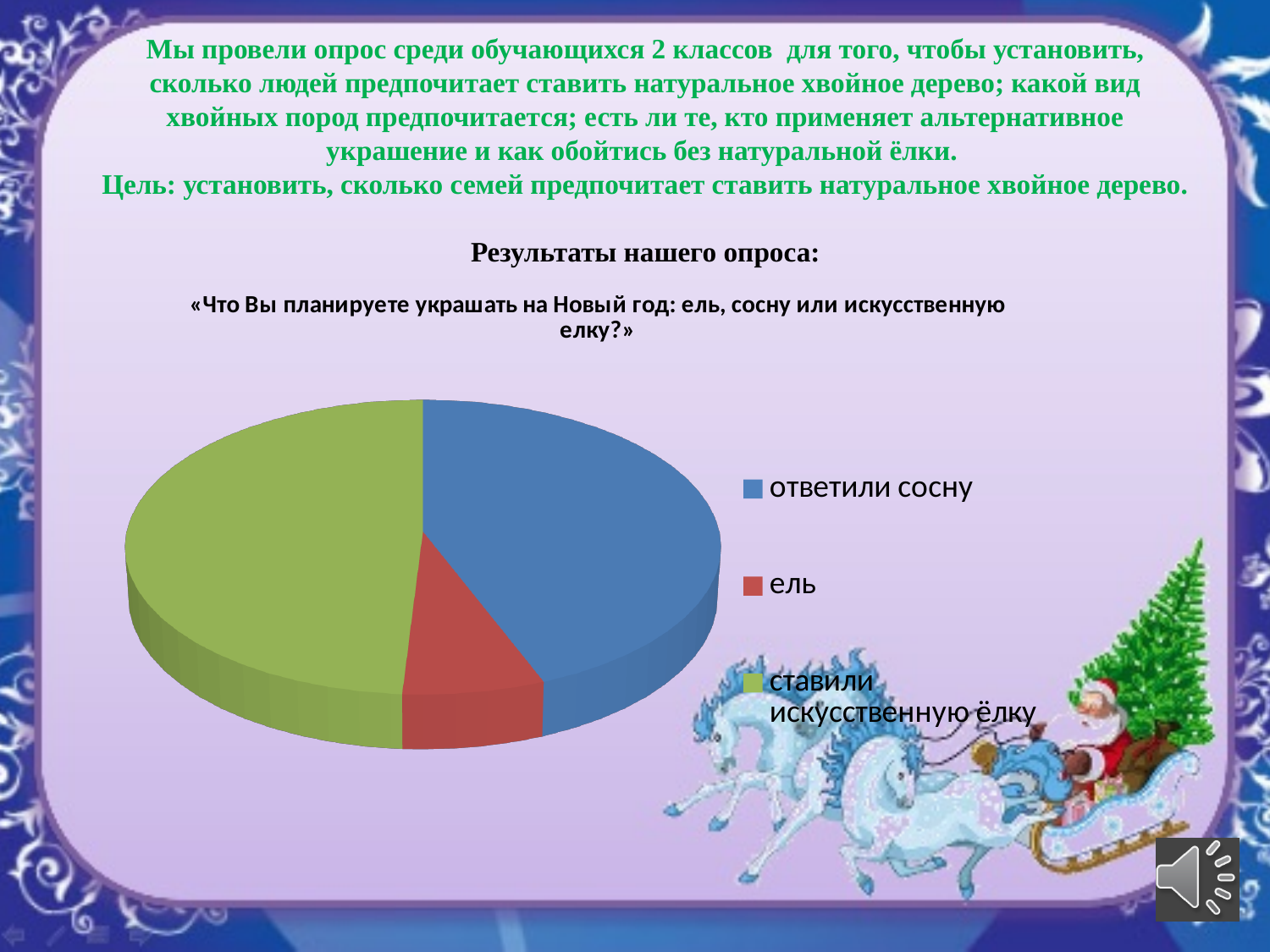
Which category has the smallest slice of the pie chart? ель Which category has the largest slice of the pie chart? ставили искусственную ёлку What kind of chart is shown on the slide? pie chart Which slice is larger: "ответили сосну" or "ель"? ответили сосну Which slice is larger: "ставили искусственную ёлку" or "ель"? ставили искусственную ёлку What colour is the slice for "ель" in the pie chart? red What is the title of the pie chart? «Что Вы планируете украшать на Новый год: ель, сосну или искусственную елку?» How many slices does the pie chart have? 3 How many entries does the legend of the pie chart list? 3